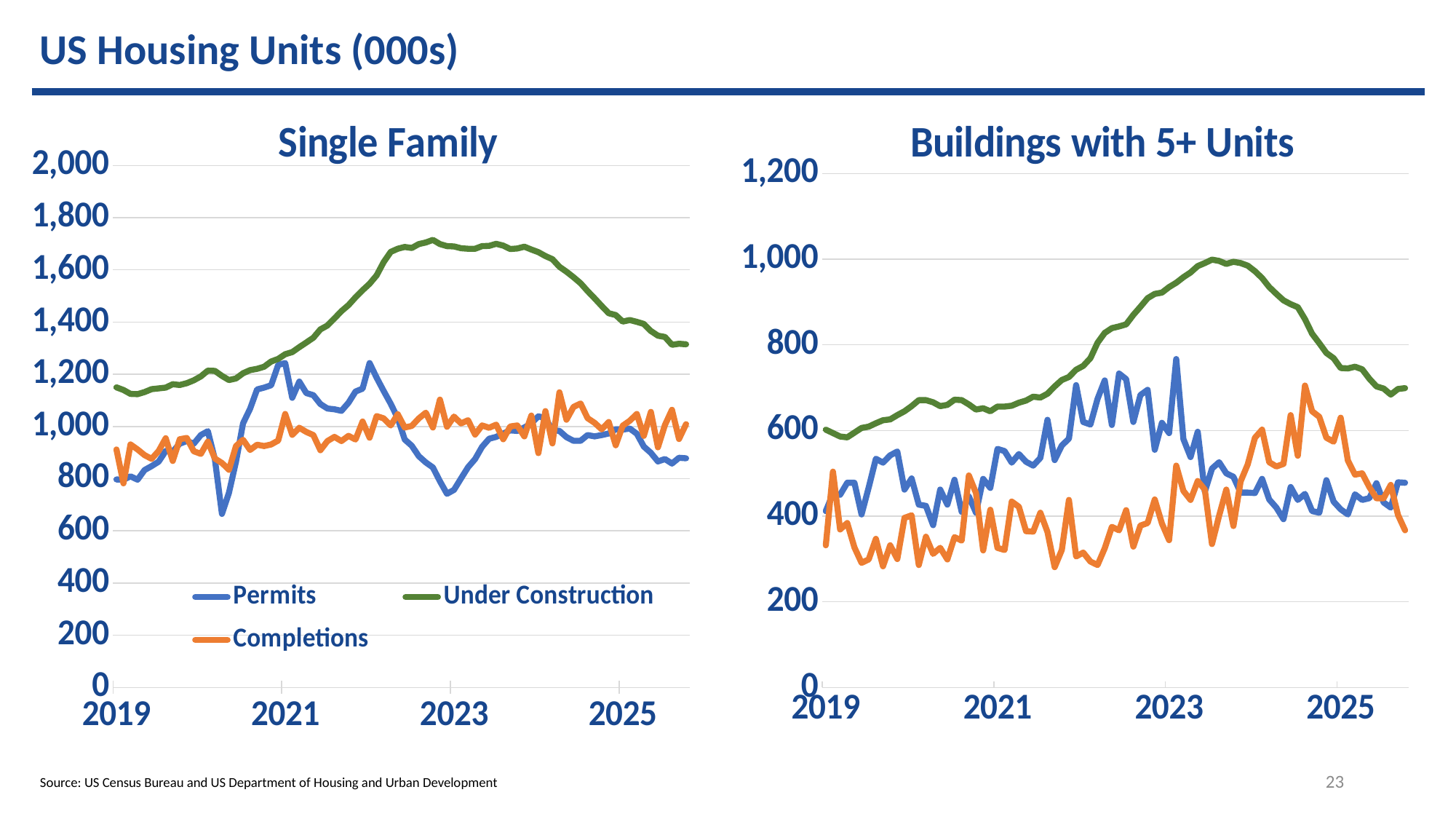
What kind of chart is the Single Family chart? line chart In the Buildings with 5+ Units chart, is the Completions value at the start of 2019 greater or less than 400? less In the Buildings with 5+ Units chart, does the Under Construction series rise or fall between 2019 and 2023? rise In the Single Family chart, does the Under Construction series rise or fall between 2024 and 2025? fall In the Buildings with 5+ Units chart, is the peak value of Under Construction greater or less than 800? greater In the Single Family chart, is the Under Construction value at the start of 2019 greater or less than 1,400? less In the Buildings with 5+ Units chart, which series has the highest values during 2024? Under Construction In the Single Family chart, which series has the highest values during 2023? Under Construction How many series does the legend list for the Single Family chart? 3 What is the title of the chart on the right side of the slide? Buildings with 5+ Units In the Buildings with 5+ Units chart, which is larger at the start of 2019: Permits or Completions? Permits